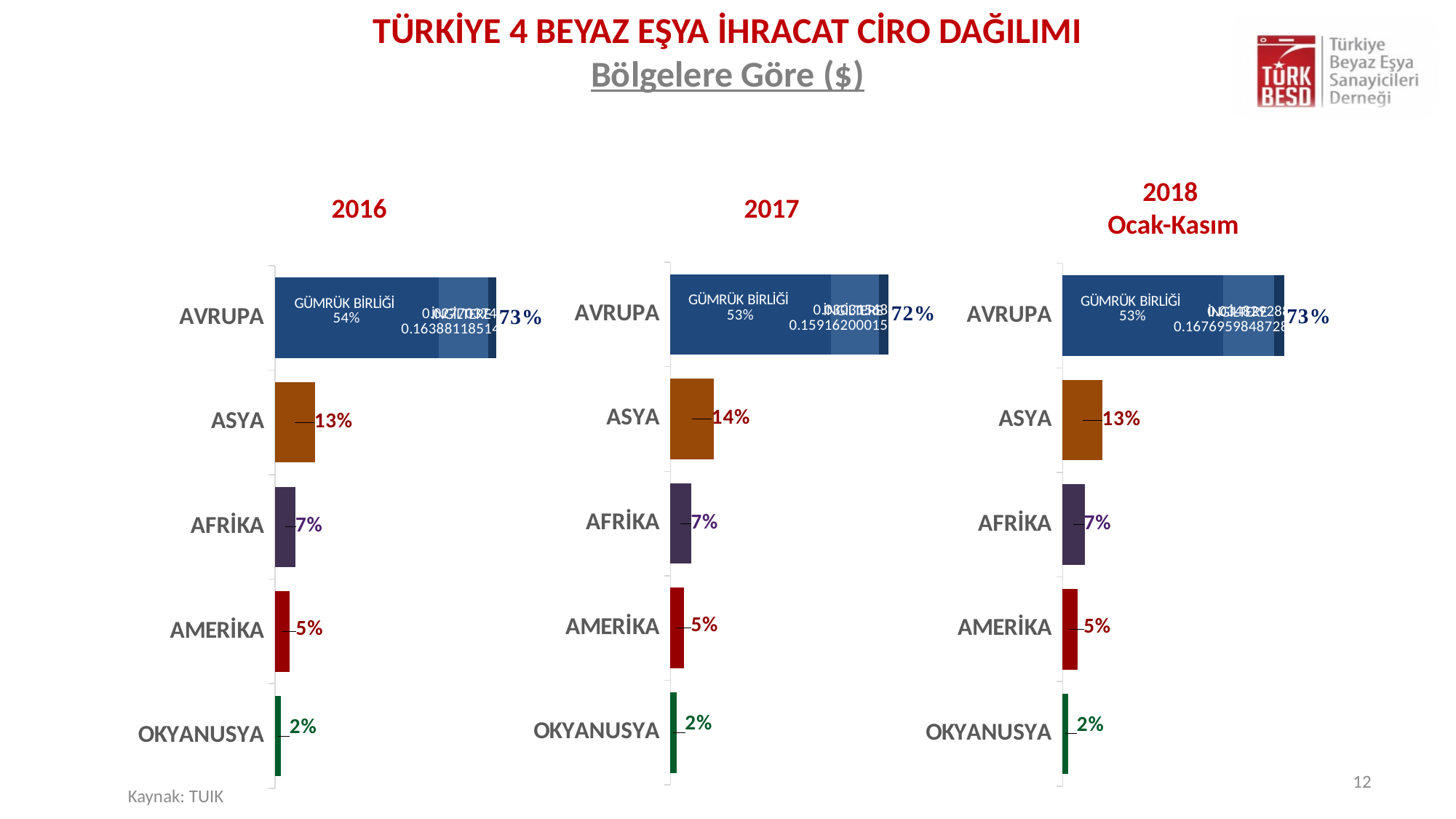
In the 2018 Ocak-Kasım chart, what is the difference between the values for AVRUPA and ASYA? 60% In the 2016 chart, what share is labelled for GÜMRÜK BİRLİĞİ within the AVRUPA bar? 54% In the 2018 Ocak-Kasım chart, what is the value for AMERİKA? 5% In the 2017 chart, what is the difference between the values for ASYA and AFRİKA? 7% What is the main title of the slide? TÜRKİYE 4 BEYAZ EŞYA İHRACAT CİRO DAĞILIMI In the 2018 Ocak-Kasım chart, which region has the lowest value? OKYANUSYA What kind of chart is the 2017 chart? Bar chart How many regions are shown in the 2016 chart? 5 In the 2017 chart, which region has the highest value? AVRUPA In the 2016 chart, which is larger, the value for AFRİKA or the value for AMERİKA? AFRİKA In the 2017 chart, what is the value for AVRUPA? 72% In the 2016 chart, what is the value for ASYA? 13%